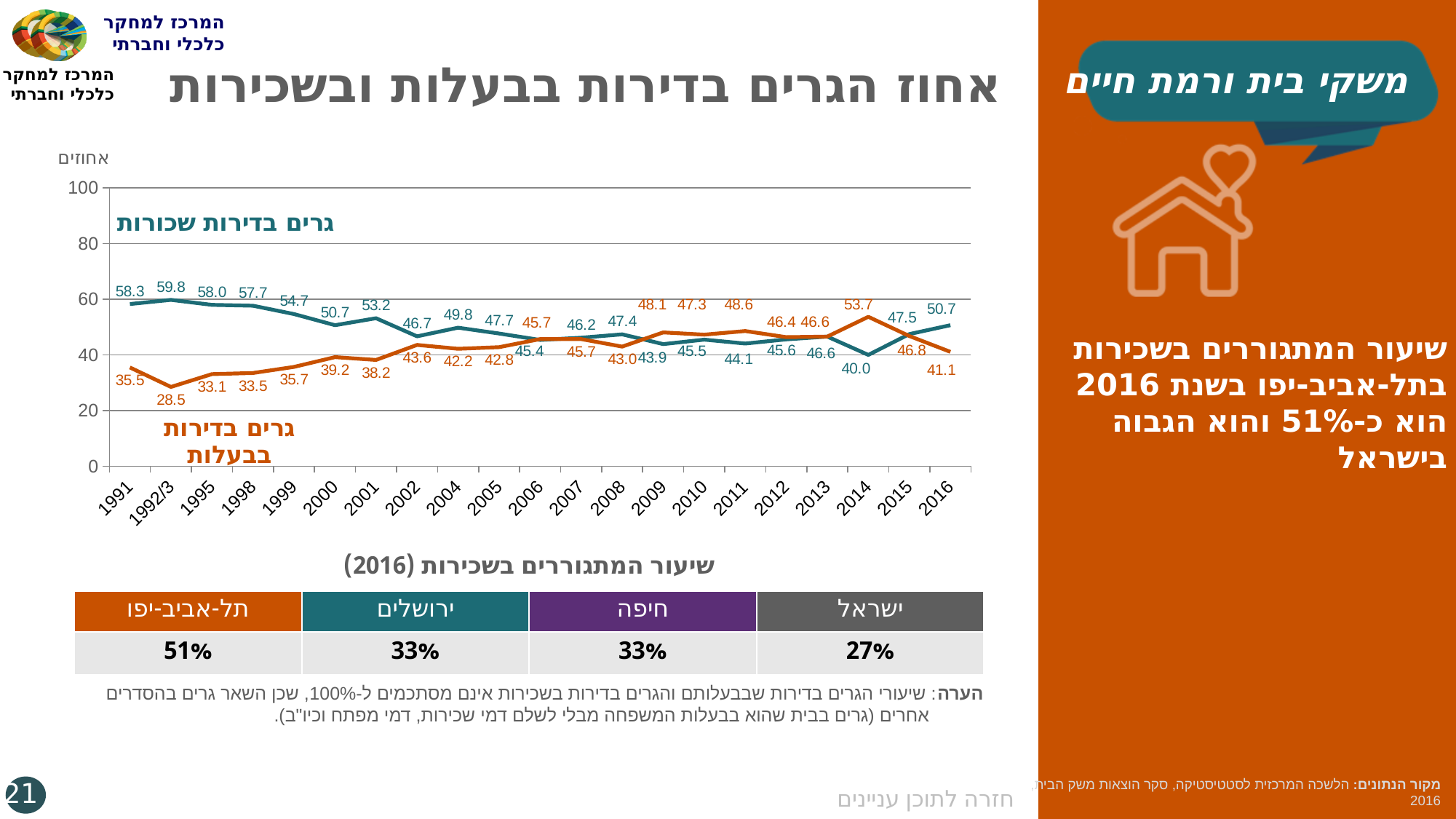
In which year does the rented apartments series (גרים בדירות שכורות) reach its highest value? 1992/3 What is the value for living in rented apartments (גרים בדירות שכורות) in 1991? 58.3 What is the difference between the rented apartments value and the owned apartments value in 2016? 9.6 How many data series are plotted in the chart? 2 In which year does the owned apartments series (גרים בדירות בבעלות) reach its lowest value? 1992/3 What type of chart is shown on the slide? line chart What is the value for living in rented apartments (גרים בדירות שכורות) in 2016? 50.7 In 2014, which series has the larger value: rented apartments or owned apartments? owned apartments (גרים בדירות בבעלות) How many years are shown on the x axis of the chart? 21 Is the value for rented apartments in 1998 greater or less than 40? greater Does the rented apartments series (גרים בדירות שכורות) generally rise or fall from 1991 to 2014? fall What is the value for living in owned apartments (גרים בדירות בבעלות) in 2014? 53.7